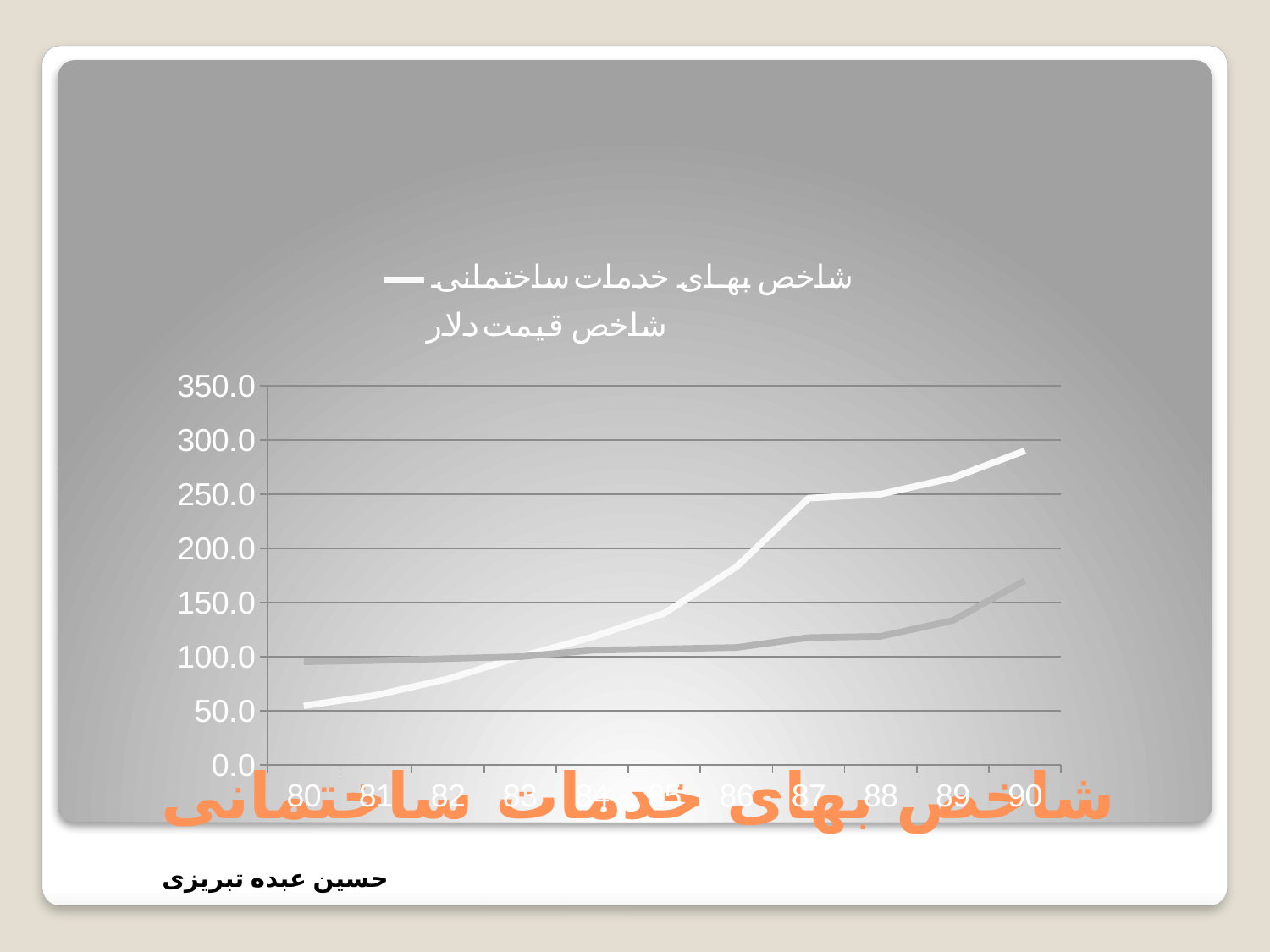
Does the value of شاخص بهای خدمات ساختمانی rise or fall from 80 to 90? rise Is the value of شاخص قیمت دلار at 90 greater or less than 150? greater In which year does شاخص بهای خدمات ساختمانی reach its highest value? 90 Is the value of شاخص بهای خدمات ساختمانی at 90 greater or less than 250? greater Is the value of شاخص بهای خدمات ساختمانی at 80 greater or less than 100? less Does the value of شاخص قیمت دلار rise or fall from 80 to 90? rise How many series does the legend list? 2 At 90, which series has the higher value? شاخص بهای خدمات ساختمانی What kind of chart is shown on the slide? line chart At 80, which series has the higher value? شاخص قیمت دلار How many points (years) are shown along the x axis? 11